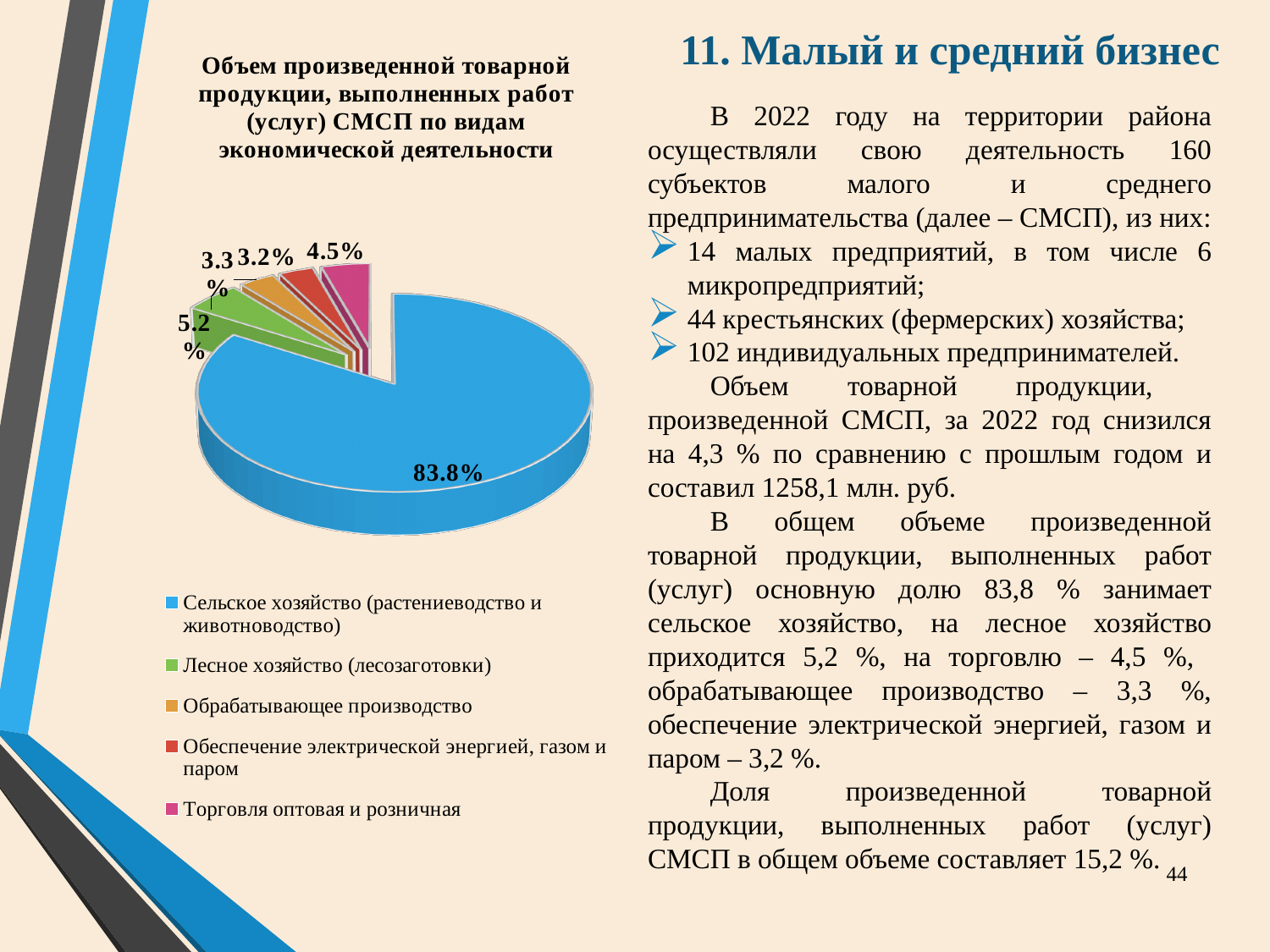
Which category has the largest slice of the pie? Сельское хозяйство (растениеводство и животноводство) What is the value shown for Обеспечение электрической энергией, газом и паром? 3.2% How many categories does the legend list? 5 Which is larger: the slice for Лесное хозяйство (лесозаготовки) or the slice for Торговля оптовая и розничная? Лесное хозяйство (лесозаготовки) Which category has the smallest slice of the pie? Обеспечение электрической энергией, газом и паром What is the value shown for Лесное хозяйство (лесозаготовки)? 5.2% What colour is the slice for Торговля оптовая и розничная? Magenta (pink) What is the difference between the share for Сельское хозяйство and the share for Лесное хозяйство? 78.6% What type of chart is shown on the slide? Pie chart What share of the pie does Сельское хозяйство (растениеводство и животноводство) have? 83.8% What is the value shown for Обрабатывающее производство? 3.3% What is the value shown for Торговля оптовая и розничная? 4.5%